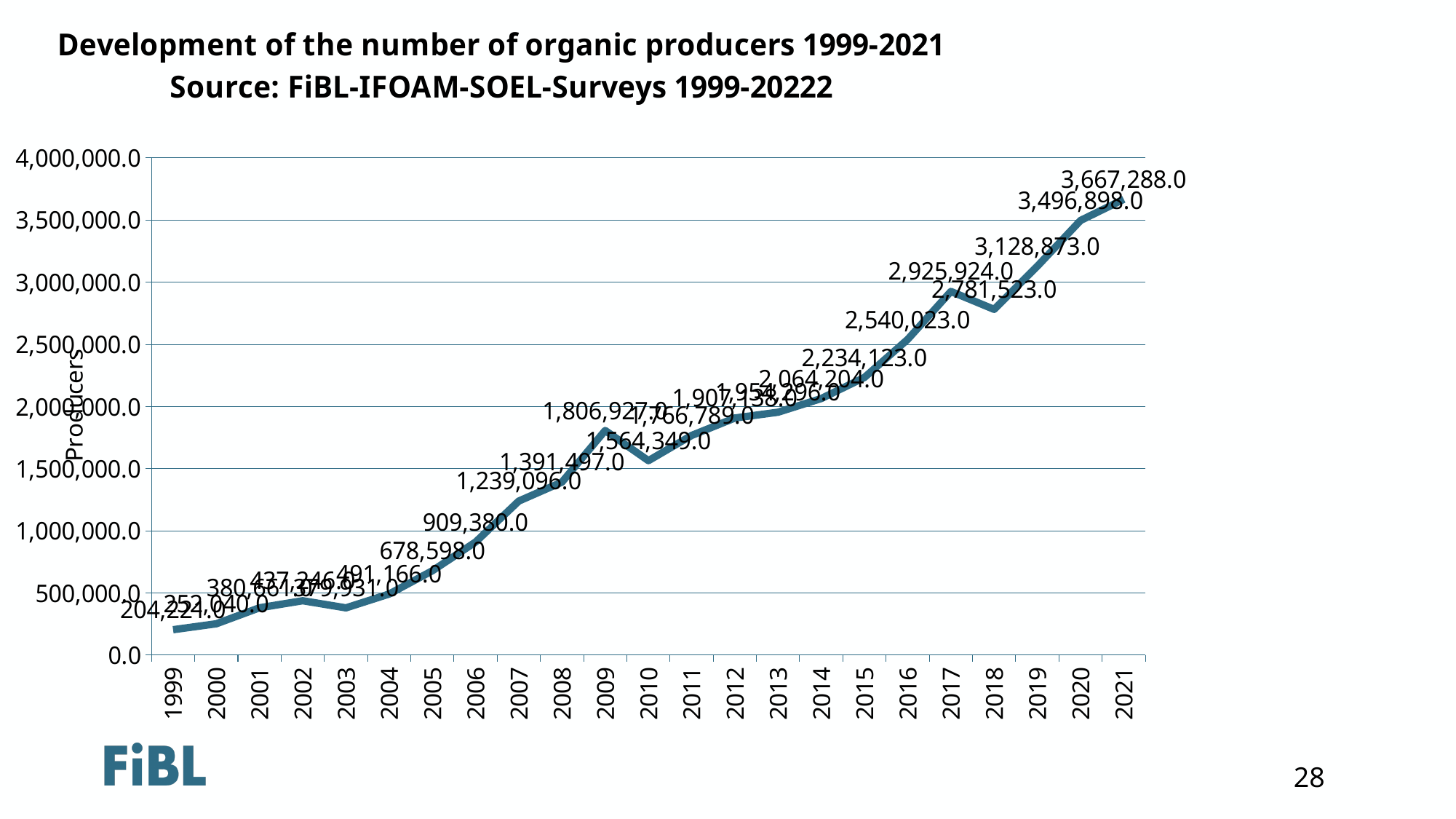
Which year has the lowest number of organic producers? 1999 What is the number of organic producers in 2016? 2,540,023.0 What is the difference between the number of producers in 2021 and in 2020? 170,390.0 Overall, do the values rise or fall from 1999 to 2021? rise What is the number of organic producers in 2021? 3,667,288.0 What kind of chart is shown on the slide? line chart Is the value for 2012 greater or less than 1,500,000.0? greater Which year has more organic producers, 2017 or 2018? 2017 What is the number of organic producers in 2010? 1,564,349.0 What is the number of organic producers in 2006? 909,380.0 Which year has the highest number of organic producers? 2021 How many years are plotted on the x axis? 23